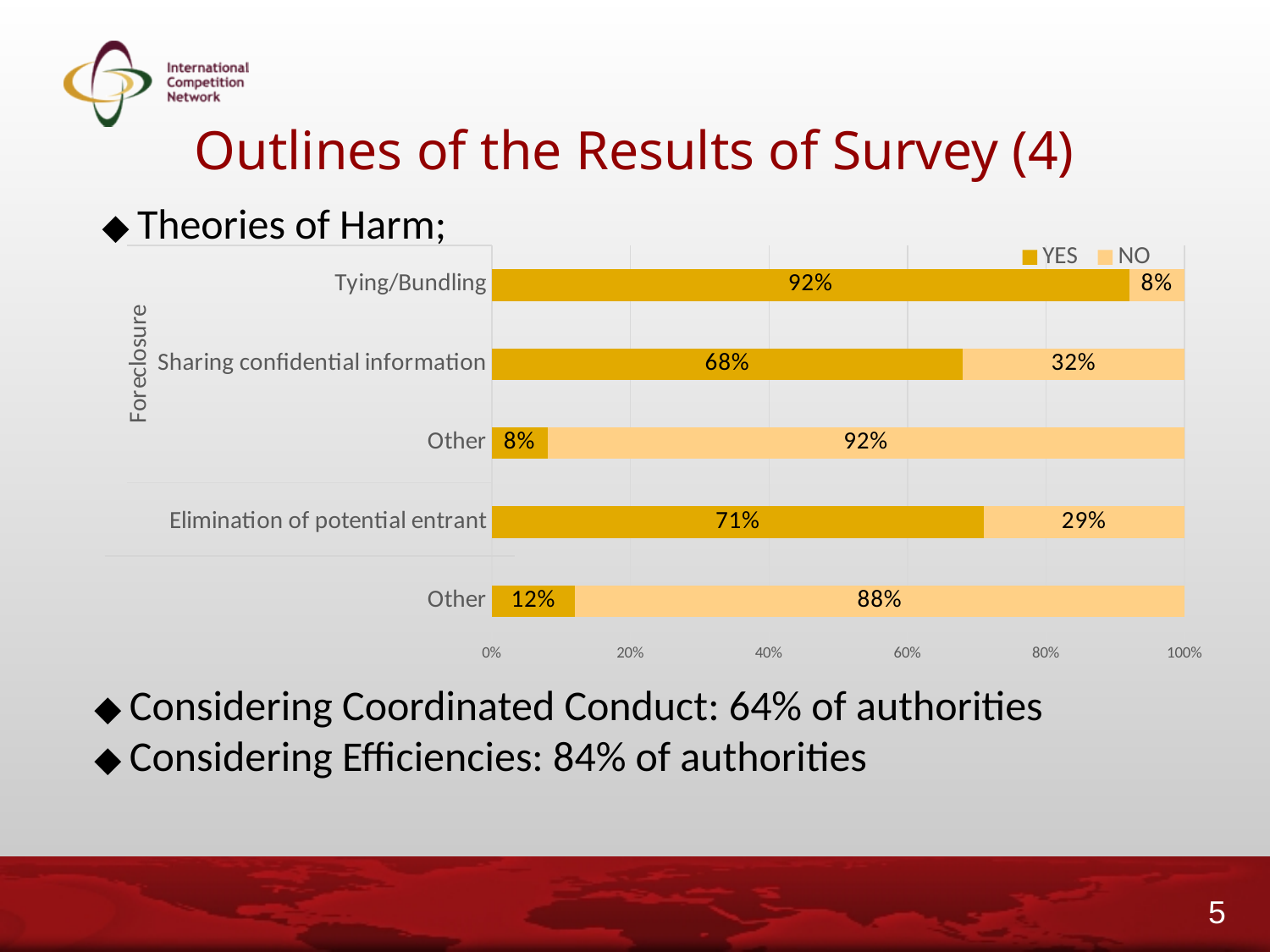
How many series does the legend list? 2 Which category has the highest YES percentage? Tying/Bundling Which is larger: the YES value for Elimination of potential entrant or the YES value for Sharing confidential information? Elimination of potential entrant What percentage of authorities answered YES for Tying/Bundling? 92% Which category has the lowest YES percentage? Other (under Foreclosure) What is the NO value for the bottom 'Other' category (the last bar in the chart)? 88% What is the difference between the YES values for Tying/Bundling and Sharing confidential information? 24% What kind of chart is shown on the slide? Stacked bar chart What is the YES value for Elimination of potential entrant? 71% How many categories are shown in the chart? 5 What is the NO value for Sharing confidential information? 32% What is the total of the YES and NO segments for Elimination of potential entrant? 100%